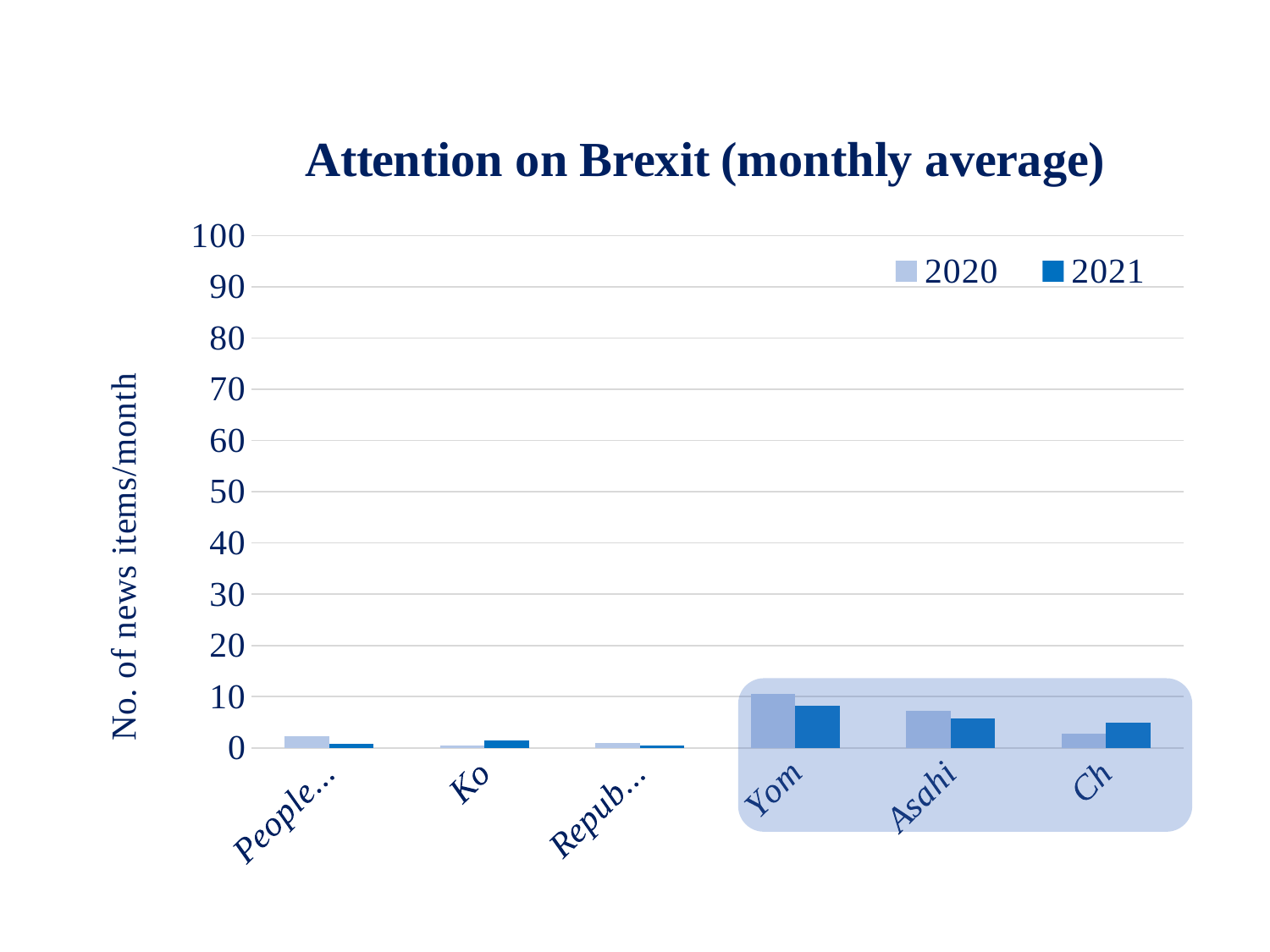
Is the 2021 value for Ch greater or less than 10? less Is the 2021 value for Yom greater or less than 10? less What kind of chart is shown on the slide? bar chart How many series does the legend list? 2 What is the title of the chart? Attention on Brexit (monthly average) For Yom, which series has the larger value, 2020 or 2021? 2020 For Ch, which series has the larger value, 2020 or 2021? 2021 Which category has the highest value for the 2020 series? Yom What is the label of the vertical axis? No. of news items/month Which category has the highest value for the 2021 series? Yom How many categories are shown on the x axis? 6 Is the 2020 value for Asahi greater or less than 10? less